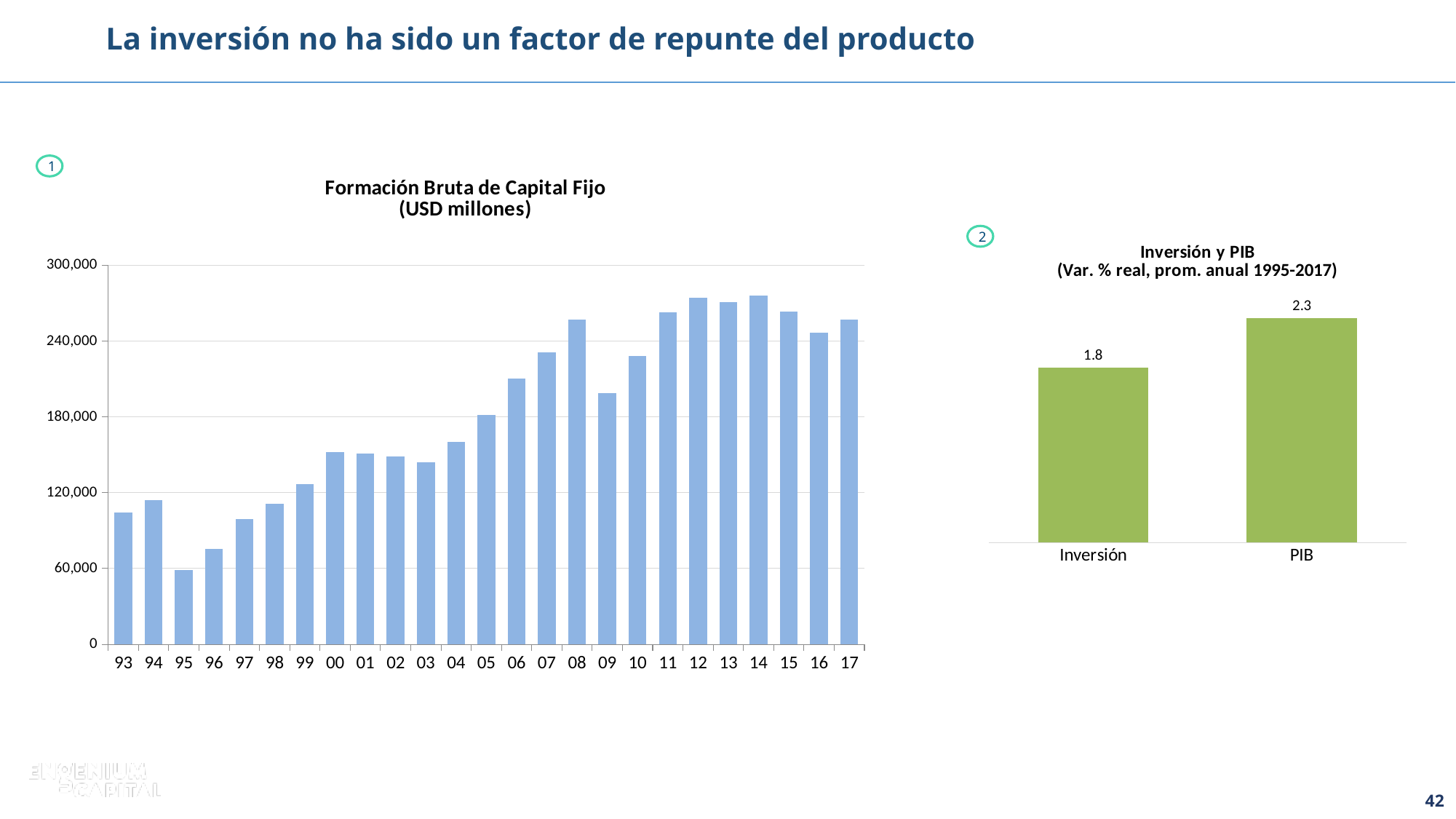
In the 'Formación Bruta de Capital Fijo' chart, is the value for 08 greater or less than 240,000? greater In the 'Formación Bruta de Capital Fijo' chart, which year has the lowest value? 95 In the 'Formación Bruta de Capital Fijo' chart, which year has the larger value, 08 or 09? 08 In the 'Inversión y PIB' chart, which is larger, Inversión or PIB? PIB In the 'Inversión y PIB' chart, what is the value for PIB? 2.3 How many years are plotted in the 'Formación Bruta de Capital Fijo' chart? 25 What kind of chart is the 'Formación Bruta de Capital Fijo' chart? bar chart How many bars are shown in the 'Inversión y PIB' chart? 2 In the 'Inversión y PIB' chart, what is the value for Inversión? 1.8 In the 'Inversión y PIB' chart, what is the difference between the PIB value and the Inversión value? 0.5 In the 'Formación Bruta de Capital Fijo' chart, is the value for 09 greater or less than 240,000? less In the 'Formación Bruta de Capital Fijo' chart, do the values generally rise or fall from 95 to 08? rise